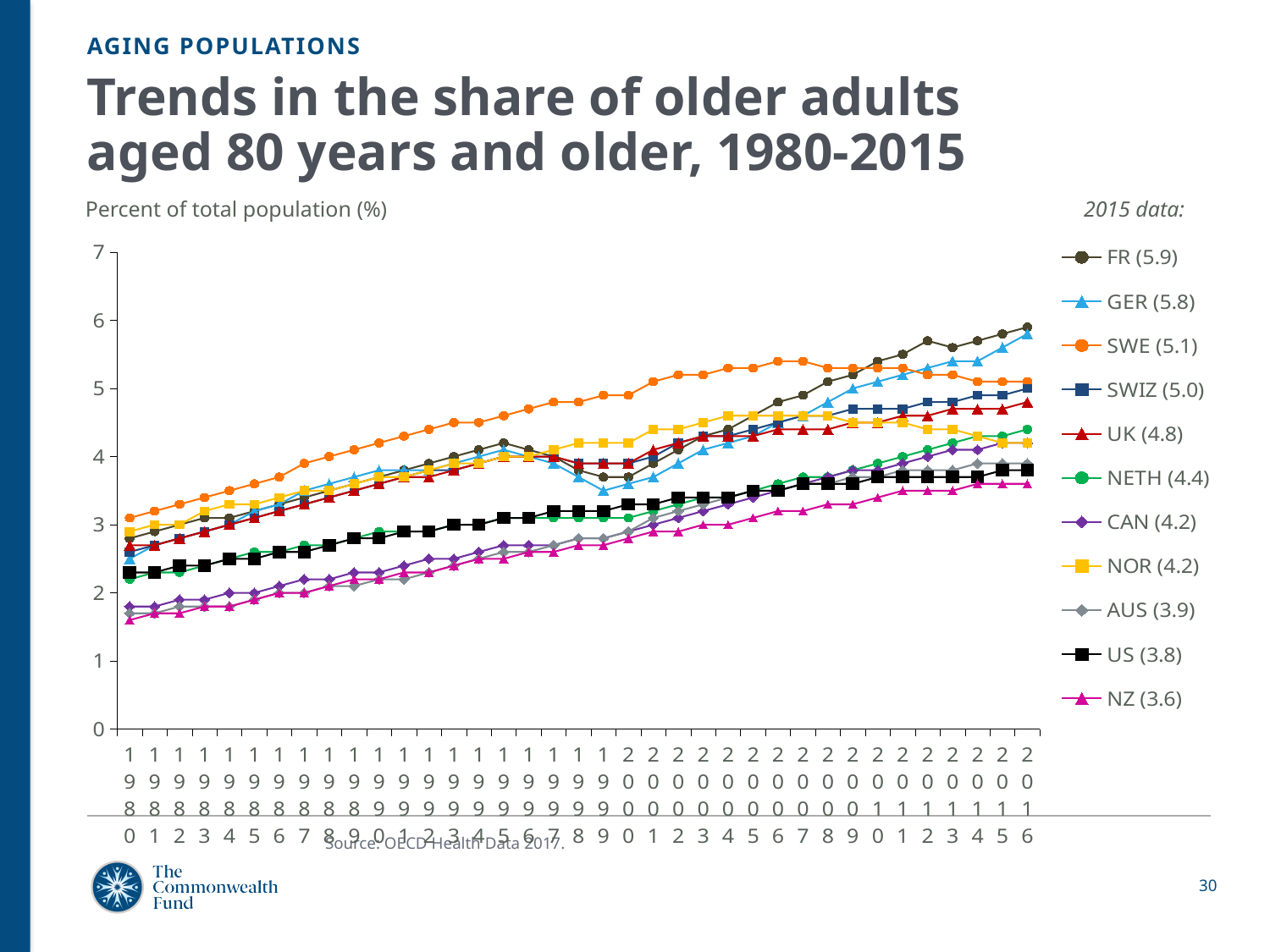
What unit is the y axis measured in, according to the label above the chart? Percent of total population (%) How many series does the legend list? 11 Is the value for US in 1980 greater or less than 3? less Which has the larger 2015 value, UK or NETH? UK According to the legend, what is the 2015 value for FR? 5.9 What is the difference between the 2015 values for SWE and US? 1.3 Which country has the lowest 2015 value shown in the legend? NZ What is the difference between the 2015 values for FR and NZ? 2.3 Does the FR line generally rise or fall from 1980 to 2016? rise According to the legend, what is the 2015 value for NZ? 3.6 Which country has the highest 2015 value shown in the legend? FR What kind of chart is shown on the slide? line chart